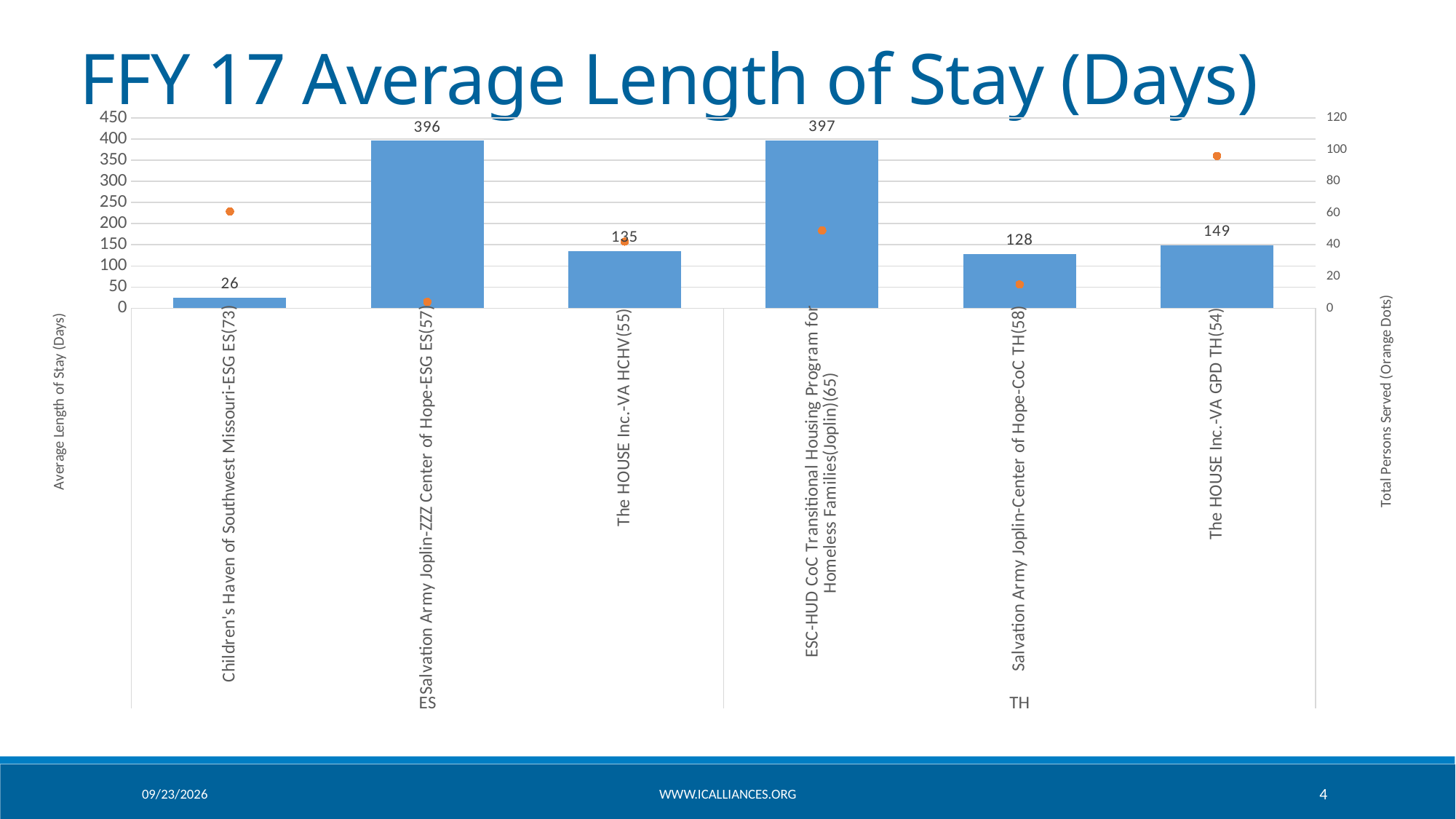
What type of chart is used to show the average length of stay? bar chart What is the average length of stay for Salvation Army Joplin-Center of Hope-CoC TH(58)? 128 What does the right-hand vertical axis measure? Total Persons Served (Orange Dots) Which program has the highest average length of stay? ESC-HUD CoC Transitional Housing Program for Homeless Families(Joplin)(65) How many programs are shown on the chart? 6 Which program has the lowest average length of stay? Children's Haven of Southwest Missouri-ESG ES(73) Is the total persons served (orange dot) for The HOUSE Inc.-VA GPD TH(54) greater or less than 80? greater Is the total persons served (orange dot) for Salvation Army Joplin-ZZZ Center of Hope-ESG ES(57) greater or less than 20? less What is the average length of stay for Children's Haven of Southwest Missouri-ESG ES(73)? 26 Which has a longer average length of stay: The HOUSE Inc.-VA HCHV(55) or Salvation Army Joplin-Center of Hope-CoC TH(58)? The HOUSE Inc.-VA HCHV(55) What is the difference in average length of stay between The HOUSE Inc.-VA GPD TH(54) and The HOUSE Inc.-VA HCHV(55)? 14 What is the average length of stay for The HOUSE Inc.-VA GPD TH(54)? 149